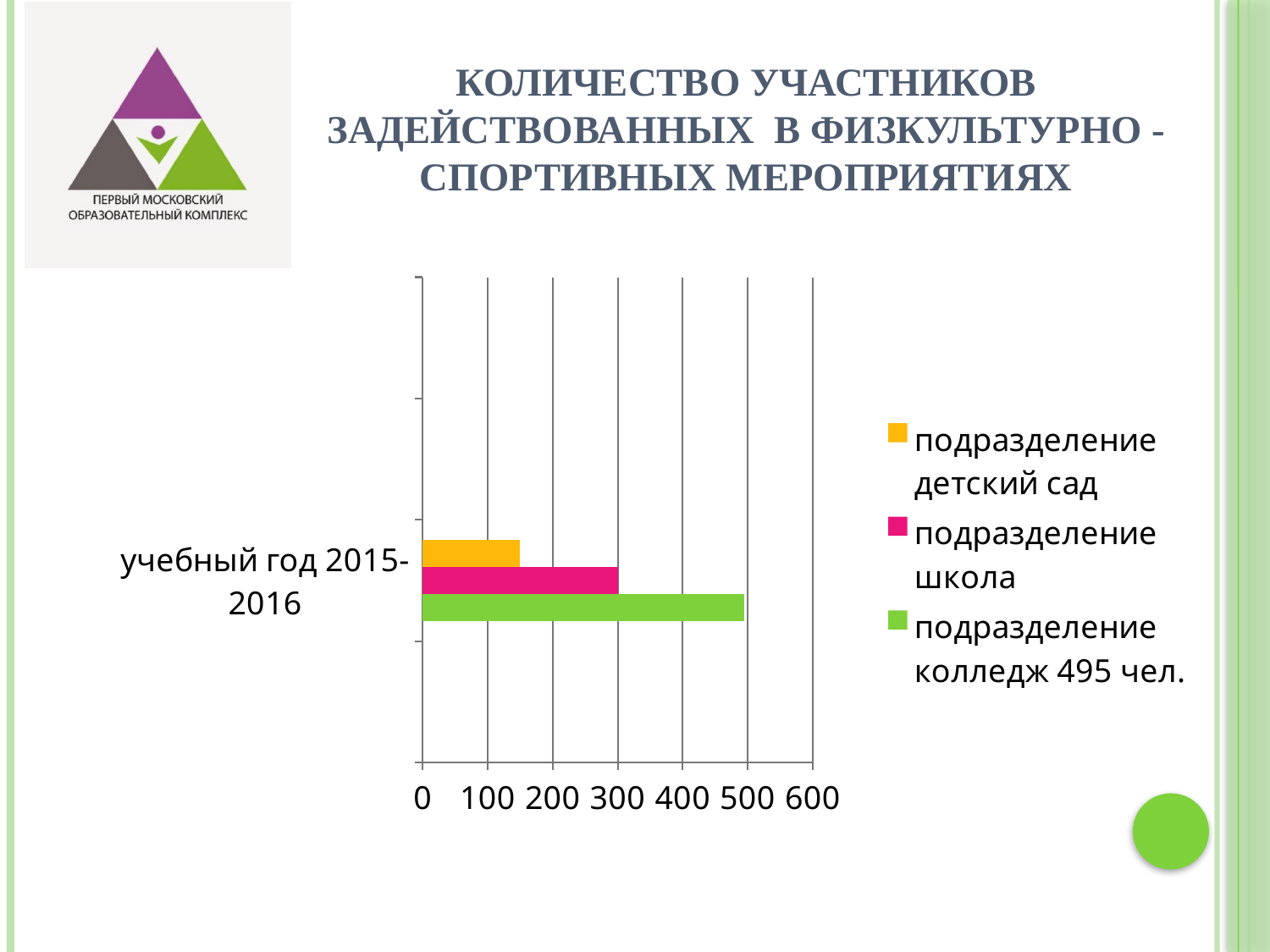
Is the value for подразделение детский сад greater or less than 200? less How many categories are shown on the vertical axis of the chart? 1 Which series has the lowest value for учебный год 2015-2016? подразделение детский сад Is the value for подразделение детский сад greater or less than 100? greater Is the value for подразделение школа greater or less than 400? less How many series does the legend list? 3 What is the highest value shown on the horizontal axis? 600 Which series has the highest value for учебный год 2015-2016? подразделение колледж According to the legend, how many participants does подразделение колледж have? 495 чел. Which is larger, the value for подразделение школа or the value for подразделение детский сад? подразделение школа What colour is the bar for подразделение школа? pink What kind of chart is shown on the slide? bar chart